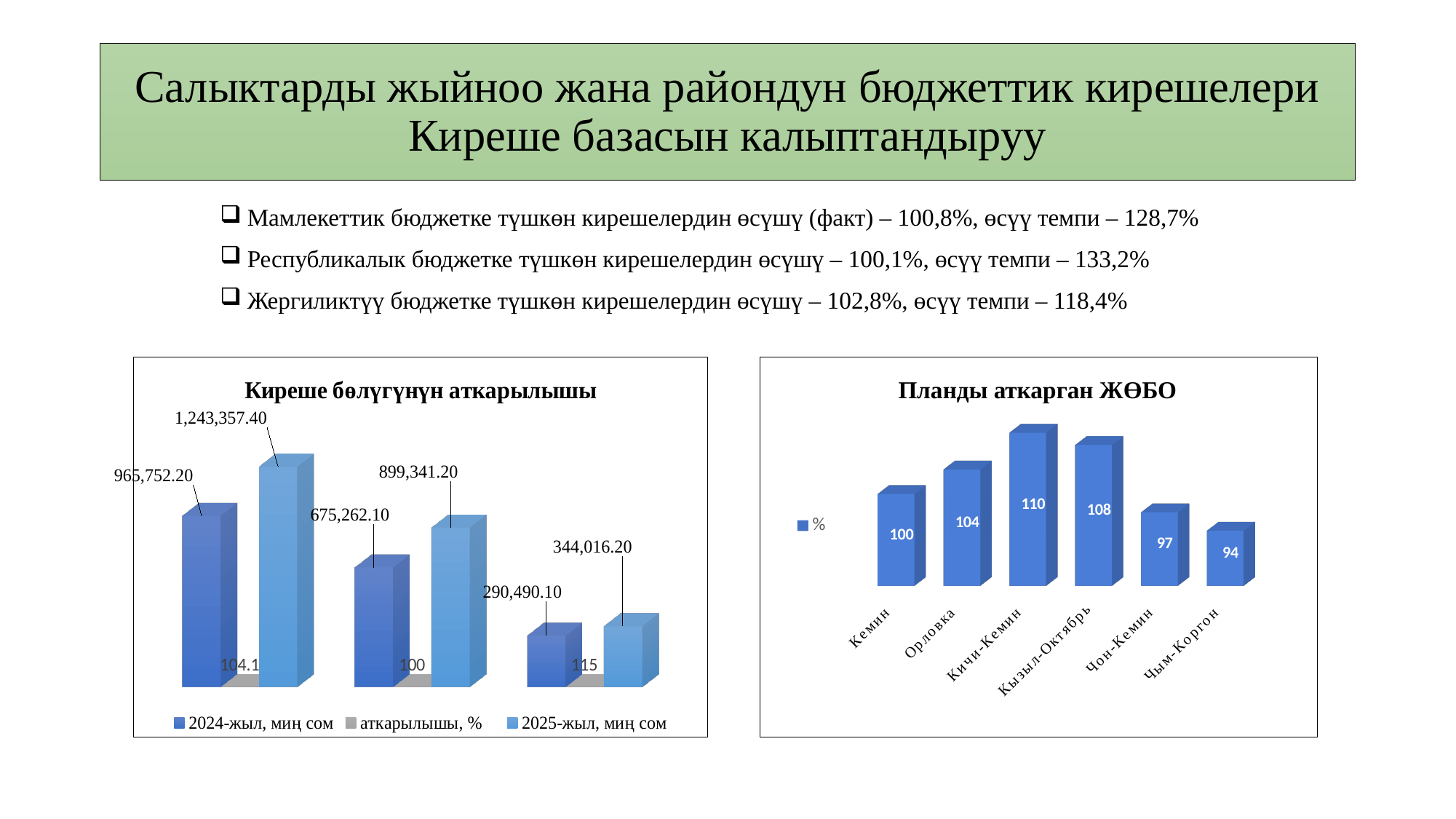
In the chart titled "Планды аткарган ЖӨБО", which category has the lowest value? Чым-Коргон In the chart titled "Планды аткарган ЖӨБО", how many categories are shown? 6 In the chart titled "Киреше бөлүгүнүн аткарылышы", what is the highest value in the "2025-жыл, миң сом" series? 1,243,357.40 In the chart titled "Планды аткарган ЖӨБО", what is the legend entry? % In the chart titled "Планды аткарган ЖӨБО", what is the value for Чым-Коргон? 94 In the chart titled "Киреше бөлүгүнүн аткарылышы", what is the lowest value in the "2024-жыл, миң сом" series? 290,490.10 In the chart titled "Планды аткарган ЖӨБО", which category has the highest value? Кичи-Кемин What kind of chart is the chart titled "Киреше бөлүгүнүн аткарылышы"? bar chart In the chart titled "Киреше бөлүгүнүн аткарылышы", how many series does the legend list? 3 In the chart titled "Планды аткарган ЖӨБО", what is the value for Кичи-Кемин? 110 In the chart titled "Планды аткарган ЖӨБО", which is larger, the value for Орловка or the value for Кемин? Орловка In the chart titled "Планды аткарган ЖӨБО", what is the difference between the values for Кызыл-Октябрь and Чон-Кемин? 11